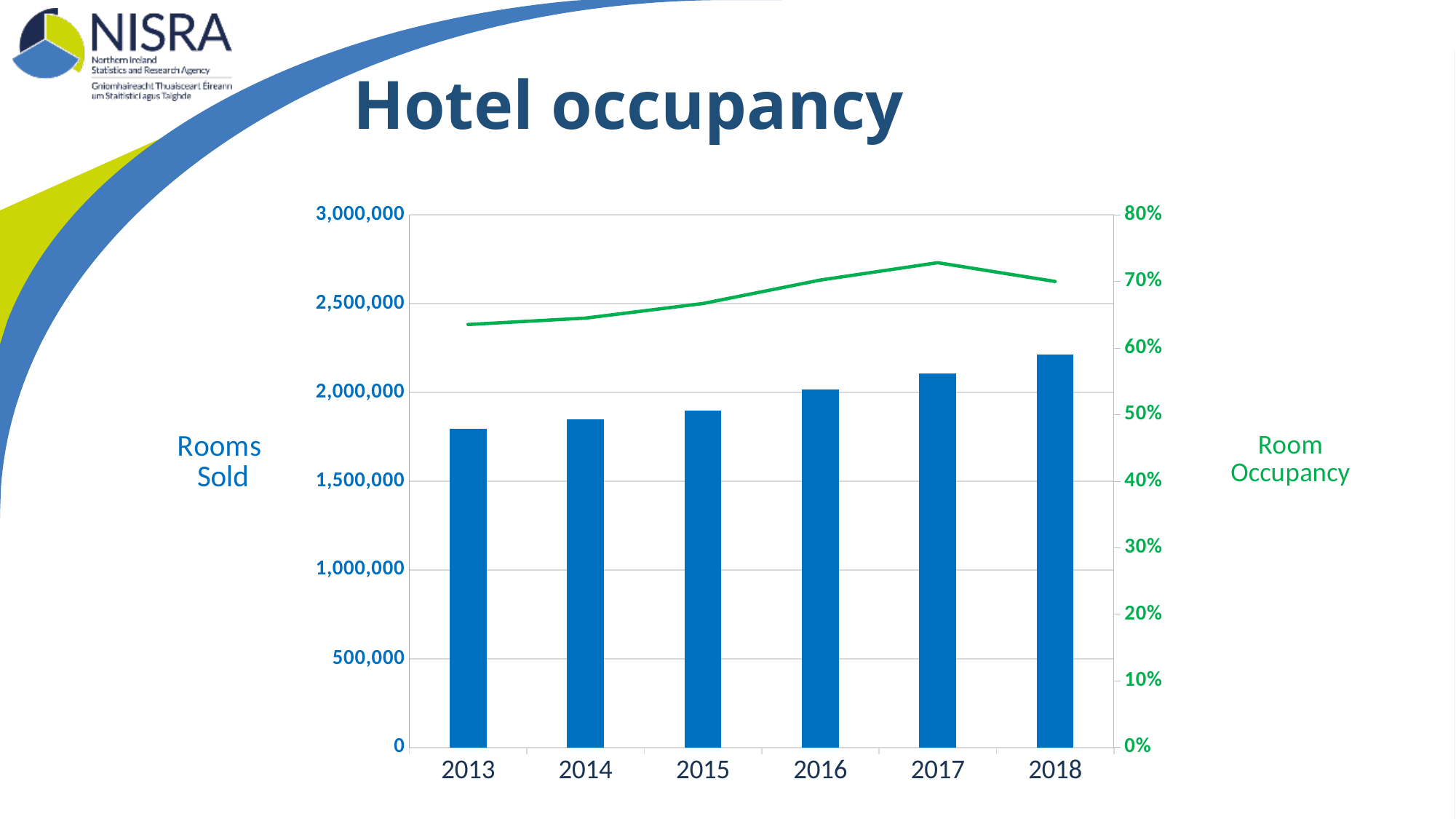
In which year does the room occupancy line reach its highest point? 2017 Which year has the highest number of rooms sold? 2018 How do the rooms sold bars change from 2013 to 2018? They rise every year Is the room occupancy in 2013 greater or less than 70%? less Is the room occupancy in 2017 greater or less than 70%? greater What does the right-hand axis of the chart measure? Room Occupancy Which year has the lowest number of rooms sold? 2013 How many years are shown on the x axis of the chart? 6 Is the number of rooms sold in 2018 greater or less than 2,000,000? greater Which year had more rooms sold, 2013 or 2018? 2018 What kind of chart is shown on the slide? A combined bar and line chart